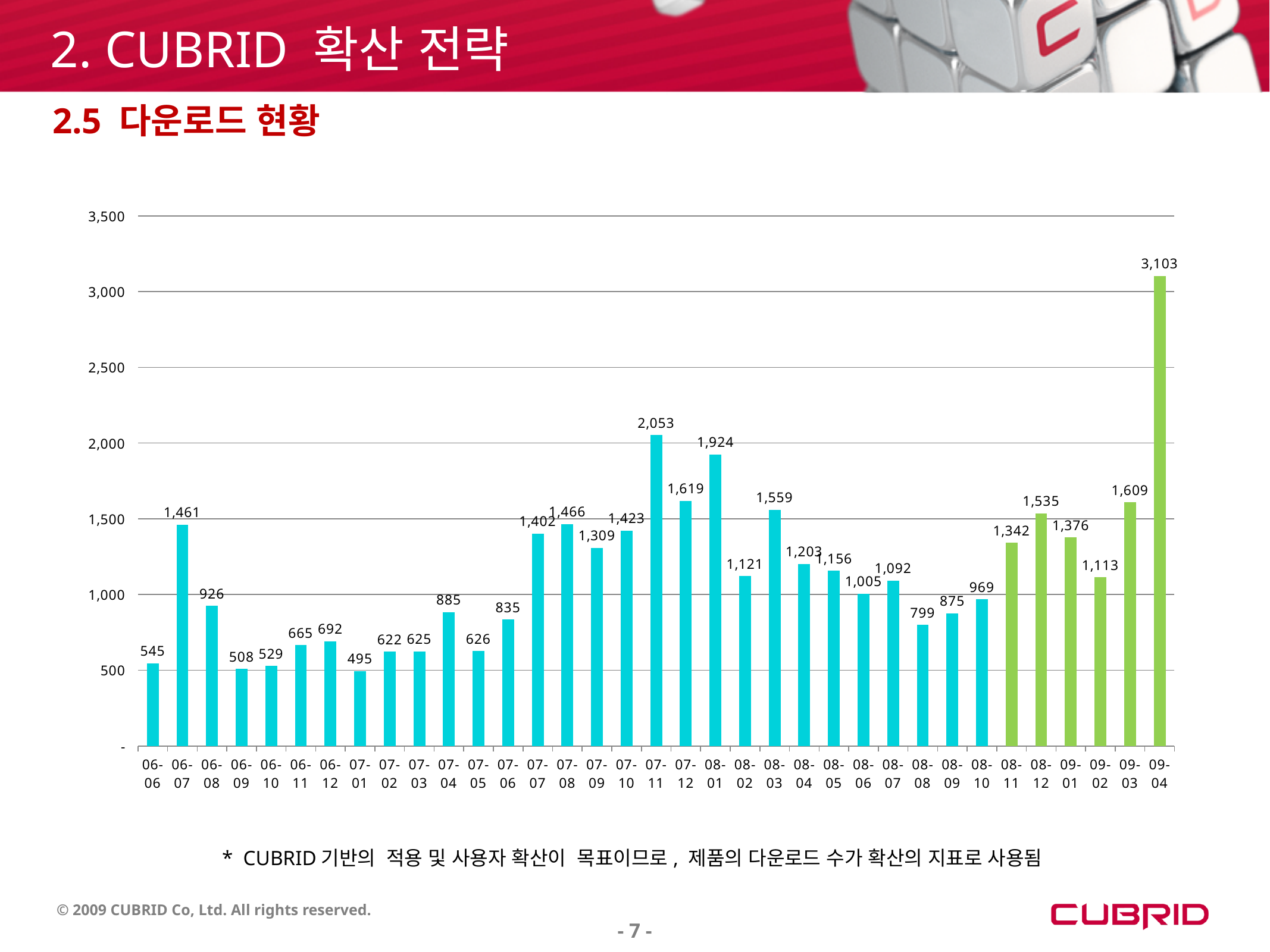
What is the difference between the values for 09-04 and 09-03? 1,494 What is the value for 09-04? 3,103 What is the value for 07-11? 2,053 What is the value for 06-07? 1,461 How many months are shown on the x axis? 35 Which month has the lowest value? 07-01 Which month has the highest value? 09-04 Which is larger, the value for 08-03 or the value for 08-11? 08-03 What kind of chart is shown on the slide? bar chart How many bars are coloured green rather than cyan? 6 What is the difference between the values for 07-11 and 08-01? 129 Is the value for 08-08 greater or less than 1,000? less